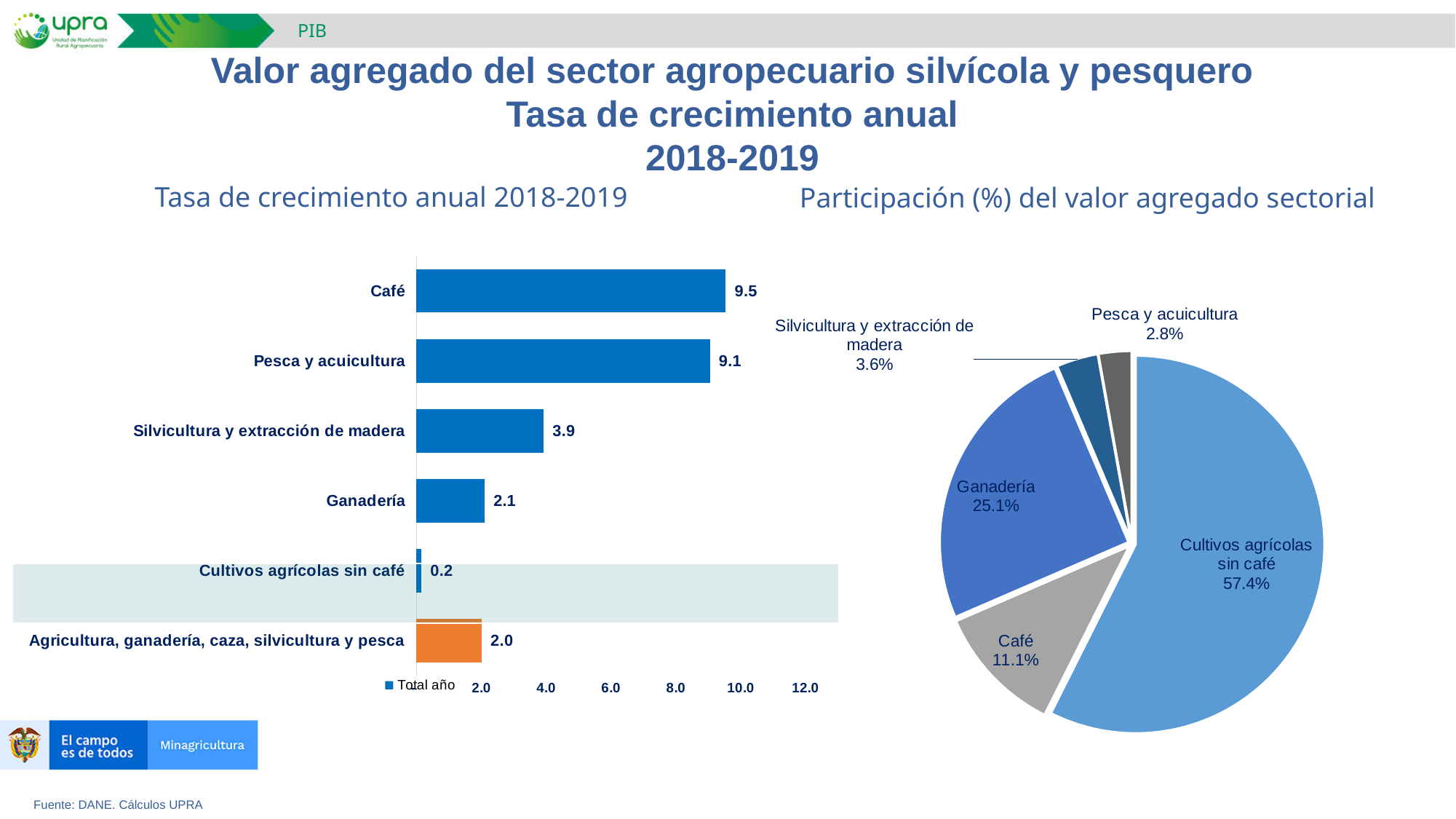
In the pie chart 'Participación (%) del valor agregado sectorial', which slice is the largest? Cultivos agrícolas sin café In the pie chart 'Participación (%) del valor agregado sectorial', what is the share for Ganadería? 25.1% In the bar chart 'Tasa de crecimiento anual 2018-2019', what is the difference between the values for Café and Pesca y acuicultura? 0.4 In the bar chart 'Tasa de crecimiento anual 2018-2019', how many categories are shown? 6 In the pie chart 'Participación (%) del valor agregado sectorial', which is larger: Café or Silvicultura y extracción de madera? Café In the pie chart 'Participación (%) del valor agregado sectorial', what is the share for Pesca y acuicultura? 2.8% In the bar chart 'Tasa de crecimiento anual 2018-2019', which category has the lowest value? Cultivos agrícolas sin café In the bar chart 'Tasa de crecimiento anual 2018-2019', what is the value for Silvicultura y extracción de madera? 3.9 What kind of chart is 'Tasa de crecimiento anual 2018-2019'? Bar chart In the bar chart 'Tasa de crecimiento anual 2018-2019', which category has the highest value? Café In the pie chart 'Participación (%) del valor agregado sectorial', how many slices are there? 5 In the bar chart 'Tasa de crecimiento anual 2018-2019', what is the value for Café? 9.5